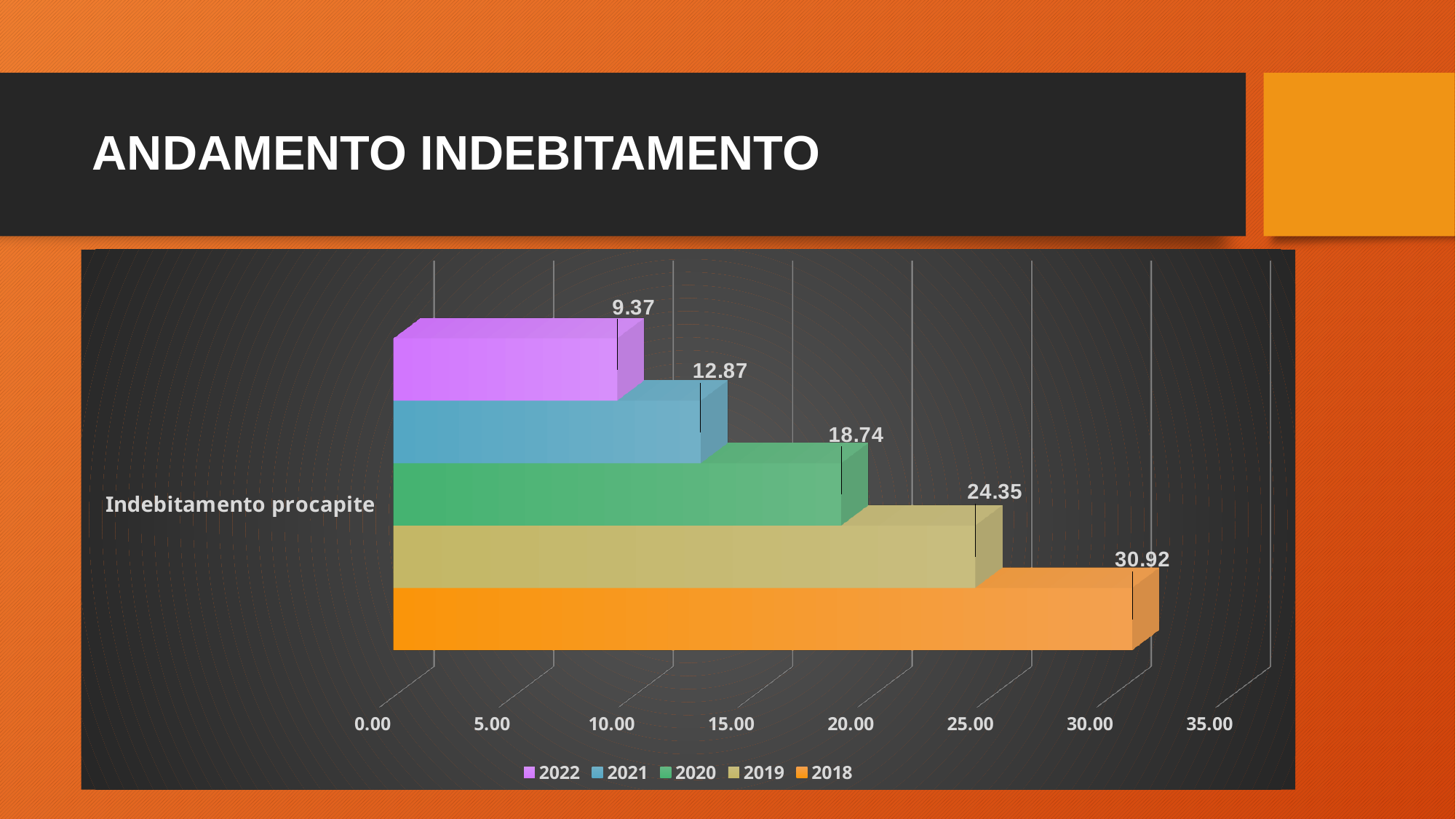
What is the difference between the 2019 and 2021 values? 11.48 How many series does the legend list? 5 Which is larger, the value for 2021 or the value for 2019? 2019 What is the title of the slide containing the chart? ANDAMENTO INDEBITAMENTO Which year has the highest Indebitamento procapite value? 2018 Which year has the lowest Indebitamento procapite value? 2022 Is the value for 2020 greater or less than 20.00? less What is the value for 2022 in the Indebitamento procapite chart? 9.37 What is the value for 2020 in the Indebitamento procapite chart? 18.74 What kind of chart is shown on the slide? bar chart What is the difference between the 2018 and 2022 values? 21.55 What is the value for 2018 in the Indebitamento procapite chart? 30.92